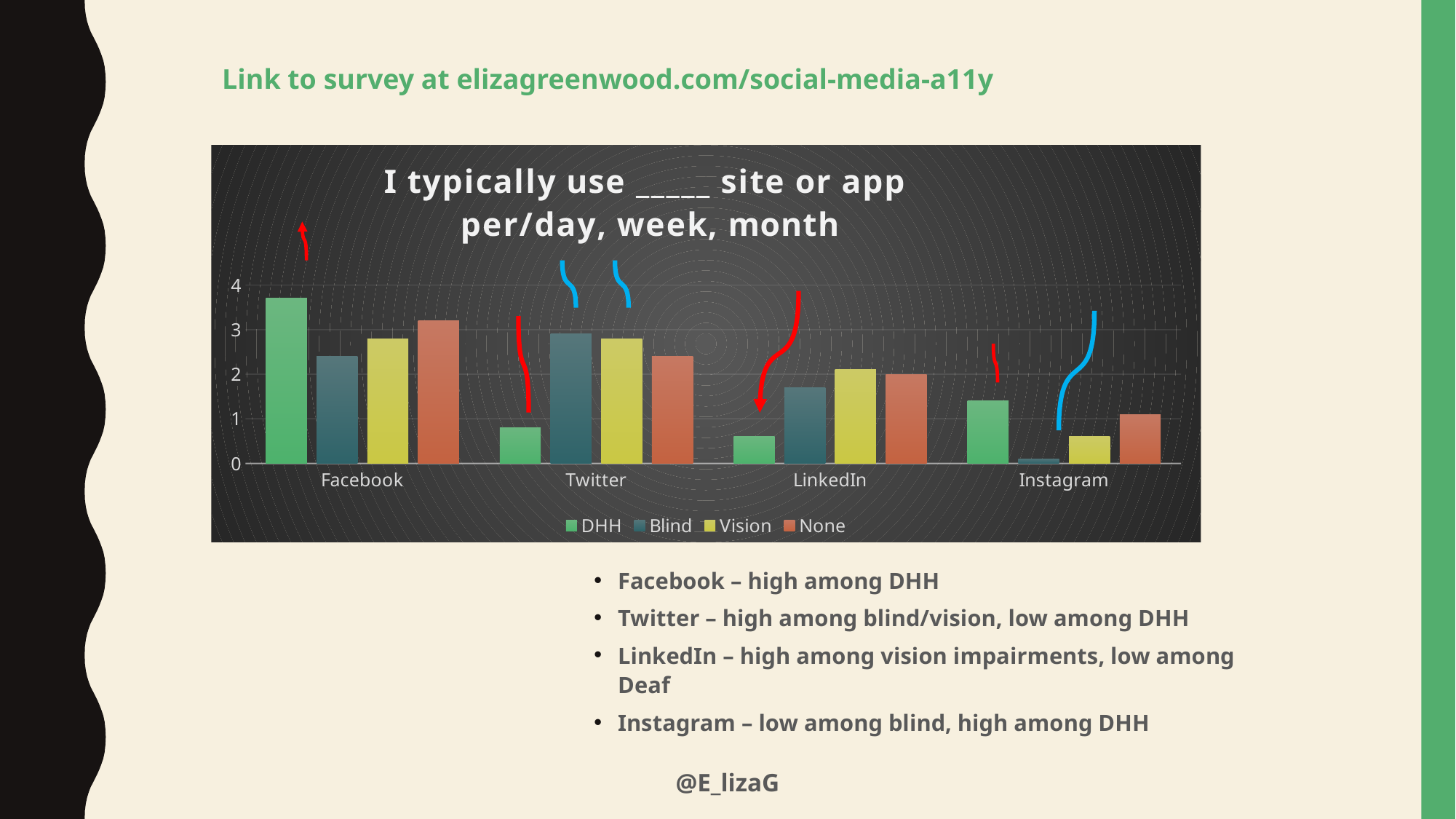
Is the DHH value for LinkedIn greater or less than 1? less Which series has the lowest value for Twitter? DHH For Instagram, which is larger: the DHH value or the Vision value? DHH What kind of chart is shown on the slide? bar chart Which category has the lowest DHH value? LinkedIn How many categories are shown on the x axis of the chart? 4 How many series does the chart's legend list? 4 Is the Blind value for Twitter greater or less than 2? greater Which series has the lowest value for Instagram? Blind Is the DHH value for Facebook greater or less than 3? greater Which series has the highest value for Facebook? DHH For LinkedIn, which is larger: the Vision value or the DHH value? Vision